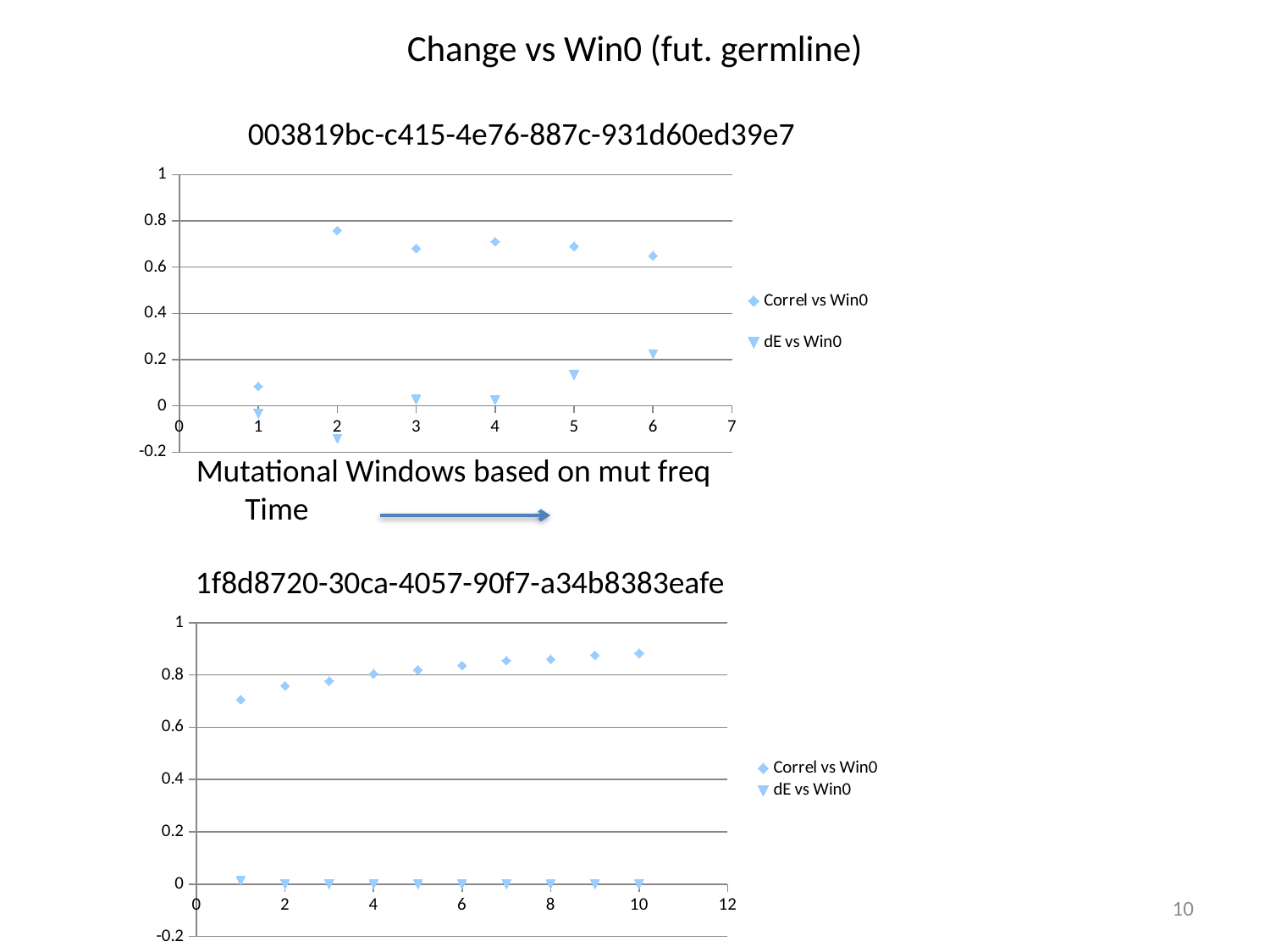
In the bottom chart (1f8d8720-30ca-4057-90f7-a34b8383eafe), is the Correl vs Win0 value at x = 10 greater or less than 0.8? greater In the top chart (003819bc-c415-4e76-887c-931d60ed39e7), is the Correl vs Win0 value at x = 2 greater or less than 0.6? greater In the top chart (003819bc-c415-4e76-887c-931d60ed39e7), is the Correl vs Win0 value at x = 1 greater or less than 0.2? less In the bottom chart (1f8d8720-30ca-4057-90f7-a34b8383eafe), what are the two legend entries? Correl vs Win0 and dE vs Win0 In the top chart (003819bc-c415-4e76-887c-931d60ed39e7), how many points are plotted for the Correl vs Win0 series? 6 In the top chart (003819bc-c415-4e76-887c-931d60ed39e7), at which x value is the dE vs Win0 series highest? 6 In the bottom chart (1f8d8720-30ca-4057-90f7-a34b8383eafe), do the Correl vs Win0 values rise or fall as x increases? rise What kind of chart is the top chart titled 003819bc-c415-4e76-887c-931d60ed39e7? scatter chart In the top chart (003819bc-c415-4e76-887c-931d60ed39e7), how many series does the legend list? 2 In the top chart (003819bc-c415-4e76-887c-931d60ed39e7), at x = 2, which series has the larger value: Correl vs Win0 or dE vs Win0? Correl vs Win0 In the bottom chart (1f8d8720-30ca-4057-90f7-a34b8383eafe), how many points are plotted for the Correl vs Win0 series? 10 In the top chart (003819bc-c415-4e76-887c-931d60ed39e7), at which x value is the dE vs Win0 series lowest? 2